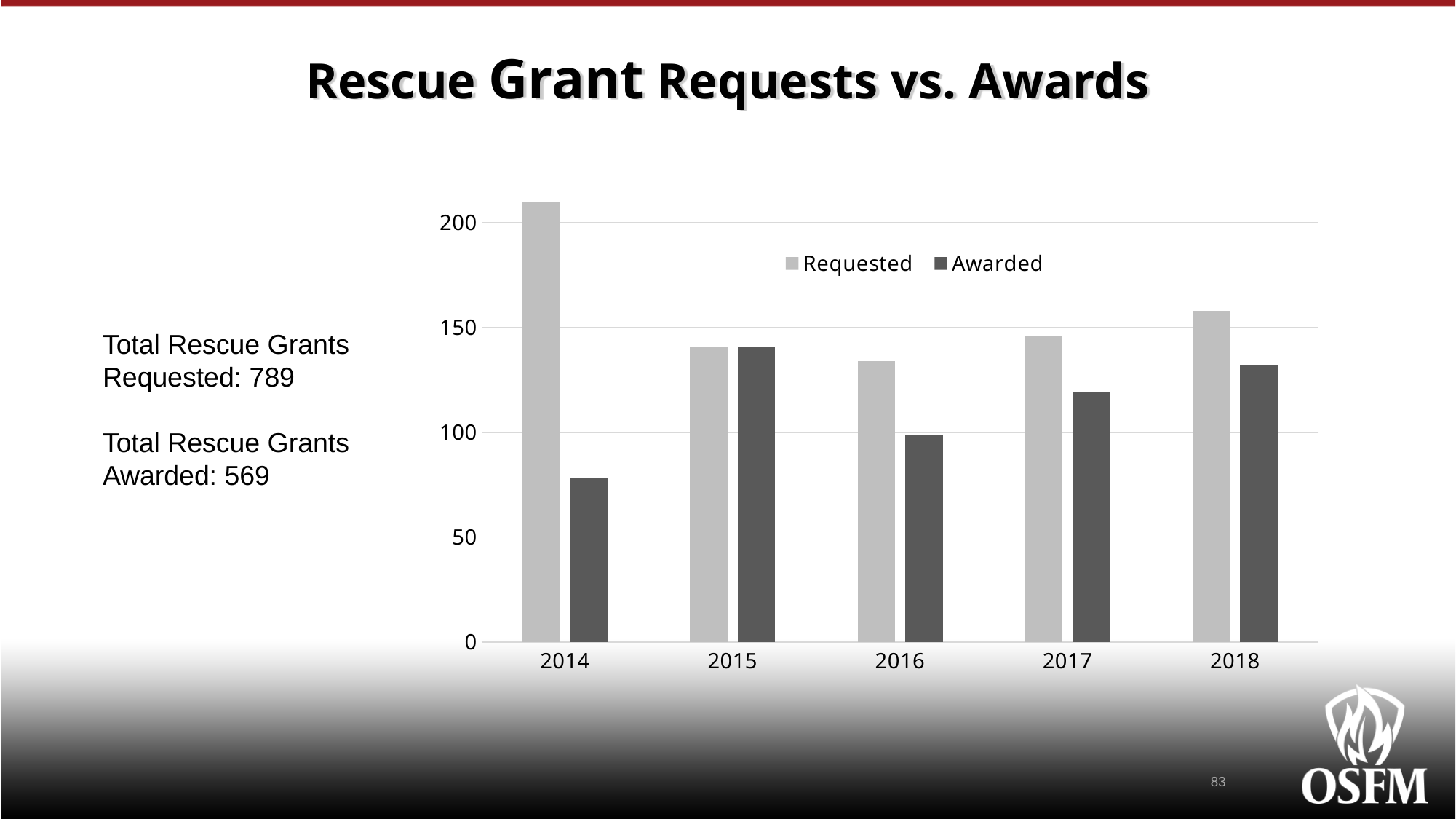
Is the Requested value for 2016 greater or less than 150? less In which year is the Awarded value lowest? 2014 Which is larger in 2018, the Requested value or the Awarded value? Requested Is the Awarded value for 2017 greater or less than 100? greater How many years are shown on the x axis of the chart? 5 What kind of chart is shown on the slide? bar chart How many series does the chart's legend list? 2 Does the Awarded value rise or fall from 2016 to 2018? rise Which two series are listed in the chart's legend? Requested and Awarded Is the Requested value for 2014 greater or less than 200? greater In which year is the Requested value highest? 2014